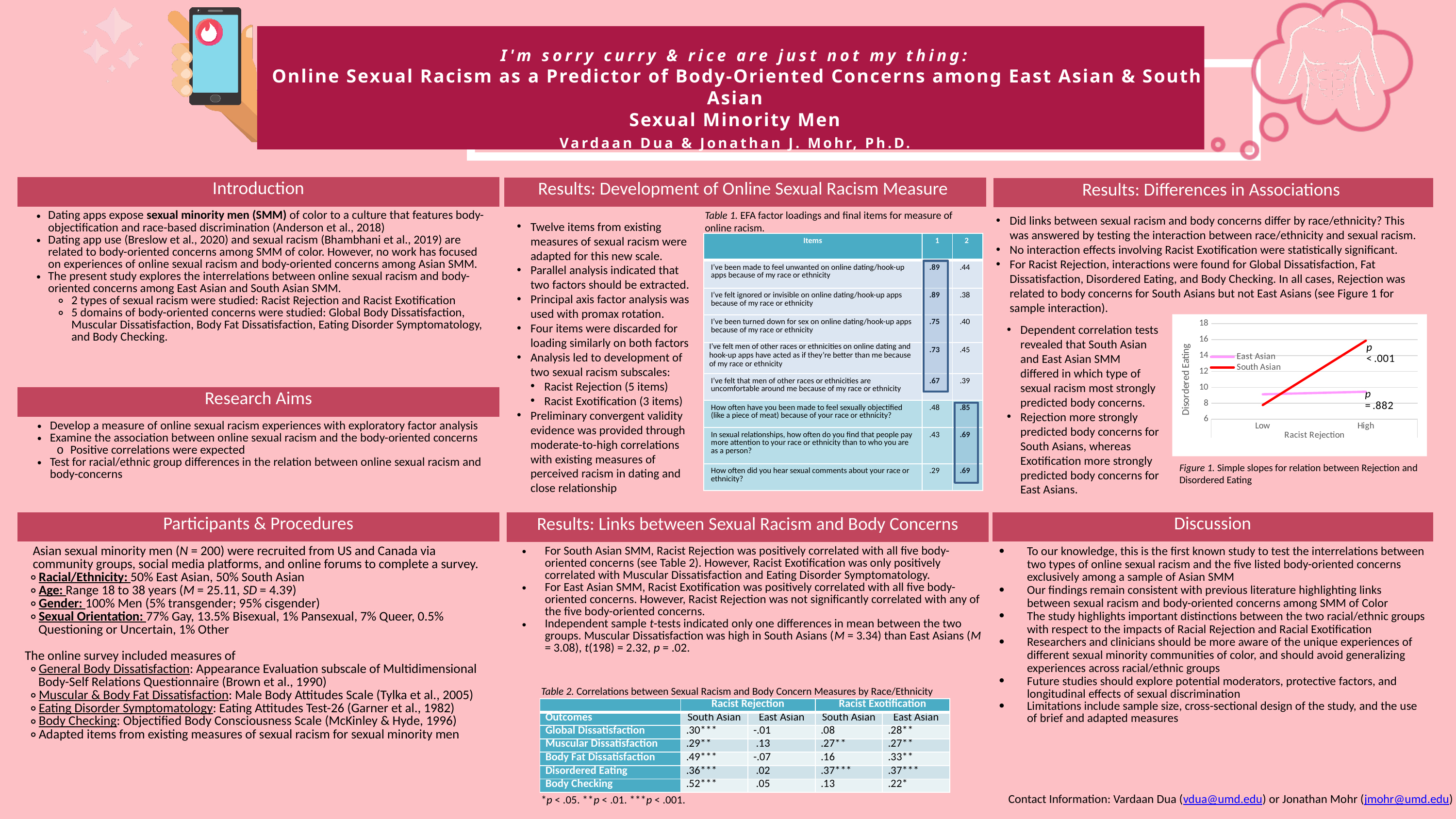
In Figure 1, is the East Asian value at High Racist Rejection greater or less than 12? less In Figure 1, does the South Asian line rise or fall from Low to High Racist Rejection? rise In Figure 1, at High Racist Rejection, which group has the higher Disordered Eating value, East Asian or South Asian? South Asian In Figure 1, what p value is printed next to the South Asian line? p < .001 How many series does the legend of Figure 1 list? 2 Which two groups are listed in the legend of Figure 1? East Asian and South Asian In Figure 1, is the South Asian value at High Racist Rejection greater or less than 14? greater In Figure 1, is the South Asian value at Low Racist Rejection greater or less than 10? less What is the label of the y axis in Figure 1? Disordered Eating How many categories are shown on the x axis of Figure 1? 2 What kind of chart is Figure 1 (Simple slopes for relation between Rejection and Disordered Eating)? line chart In Figure 1, what p value is printed next to the East Asian line? p = .882